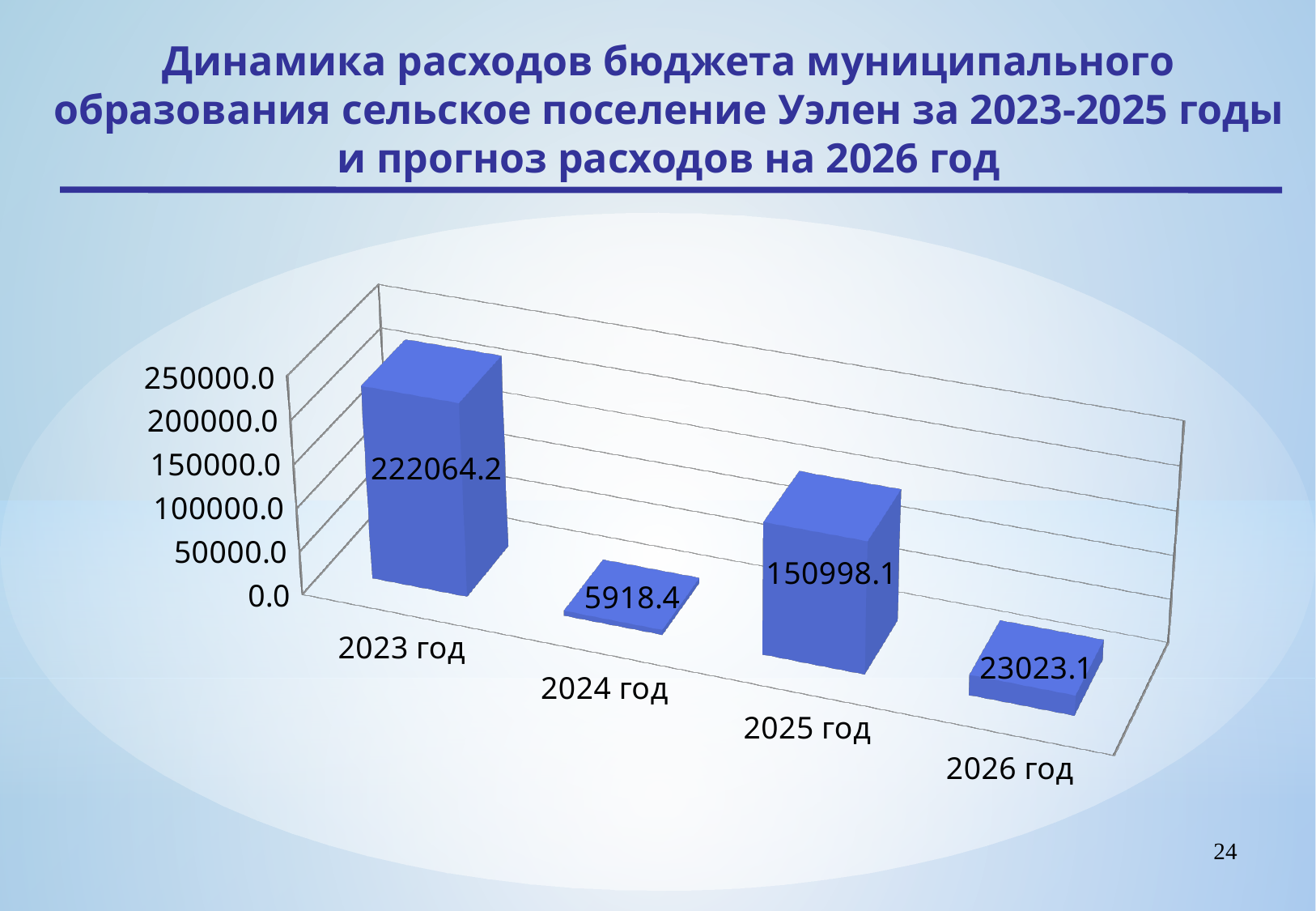
What is the difference between the values for 2026 год and 2024 год? 17104.7 Which year has the highest value? 2023 год How many years are shown on the chart? 4 Which year has the lowest value? 2024 год What is the value for 2024 год? 5918.4 What is the value for 2025 год? 150998.1 What is the difference between the values for 2023 год and 2025 год? 71066.1 Is the value for 2025 год greater or less than 100000.0? greater Which is larger, the value for 2026 год or the value for 2024 год? 2026 год What kind of chart is shown on the slide? bar chart What is the value for 2023 год? 222064.2 What is the value for 2026 год? 23023.1